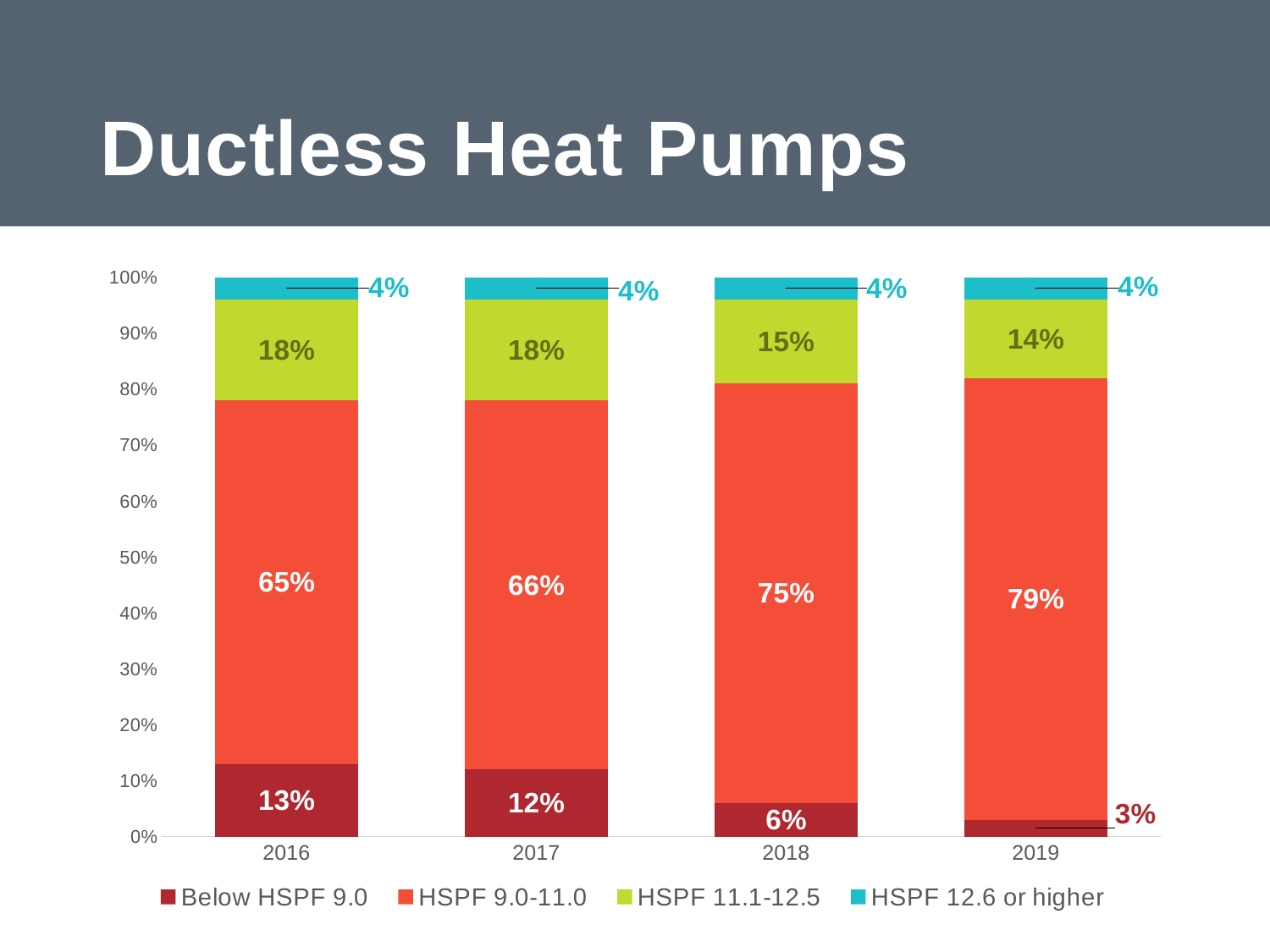
Does the Below HSPF 9.0 share rise or fall from 2016 to 2019? Fall What share of ductless heat pumps in 2016 were Below HSPF 9.0? 13% What kind of chart is shown on the slide? Stacked bar chart In which year was the HSPF 9.0-11.0 share the highest? 2019 Which is larger: the HSPF 11.1-12.5 share in 2016 or in 2018? 2016 By how many percentage points did the HSPF 9.0-11.0 share change from 2016 to 2019? 14 percentage points What share of ductless heat pumps in 2017 were HSPF 12.6 or higher? 4% How many series does the legend list? 4 What share of ductless heat pumps in 2019 were HSPF 11.1-12.5? 14% What share of ductless heat pumps in 2018 were HSPF 9.0-11.0? 75% In which year was the Below HSPF 9.0 share the lowest? 2019 How many years are shown on the x axis? 4